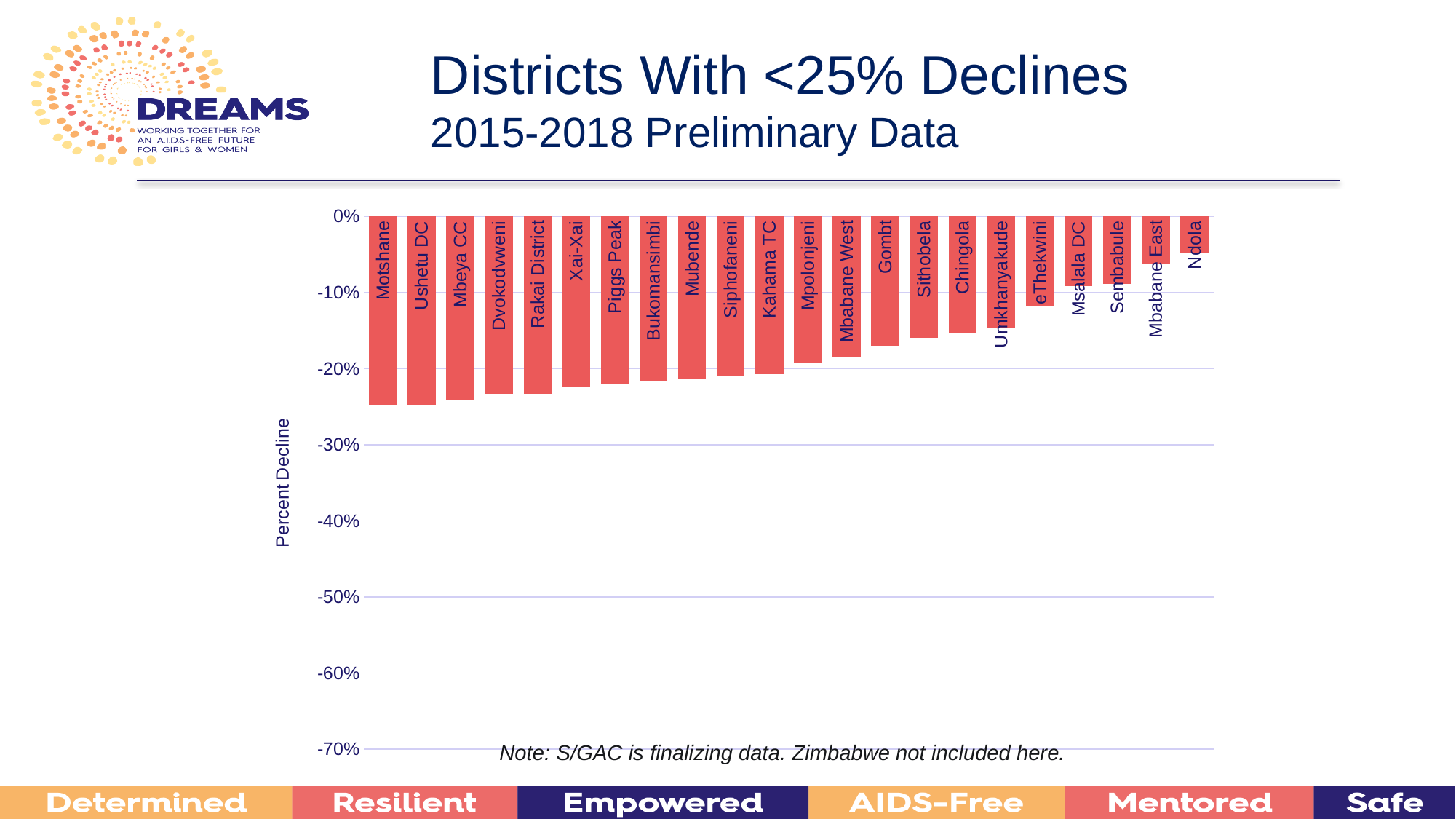
Is the bar for Mpolonjeni above or below the -20% gridline? above What is the label on the vertical axis of the chart? Percent Decline Which district shows the smallest percent decline in the chart? Ndola Do the percent declines get larger or smaller in magnitude moving from left to right across the chart? smaller What kind of chart is shown on the slide? bar chart Is the bar for Ndola above or below the -10% gridline? above Is the bar for Motshane above or below the -20% gridline? below Which district has a larger percent decline, Motshane or Ndola? Motshane Which district shows the largest percent decline in the chart? Motshane Which district has a larger percent decline, Mpolonjeni or Chingola? Mpolonjeni How many districts are plotted in the chart? 22